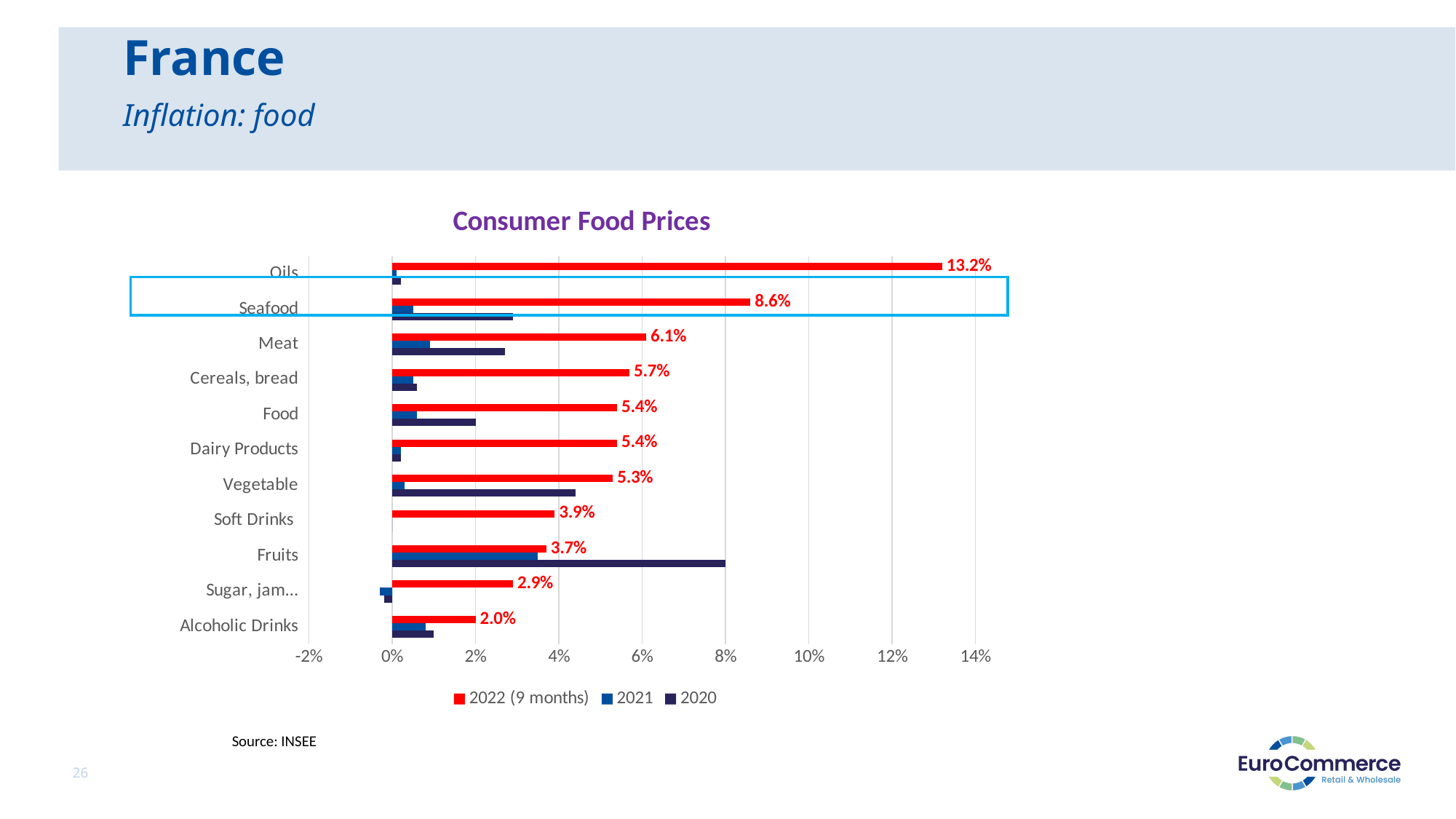
Is the 2020 value for Fruits greater or less than 6%? greater What is the 2022 (9 months) value for Soft Drinks? 3.9% How many series does the legend list? 3 Which category has the lowest 2022 (9 months) value? Alcoholic Drinks What is the 2022 (9 months) value for Seafood? 8.6% What is the difference between the 2022 (9 months) values for Oils and Seafood? 4.6 percentage points Which has the larger 2022 (9 months) value, Meat or Cereals, bread? Meat How many categories are shown on the chart? 11 What kind of chart is shown on the slide? Bar chart Is the 2020 value for Meat greater or less than 4%? less Which category has the highest 2022 (9 months) value? Oils What is the 2022 (9 months) value for Oils? 13.2%